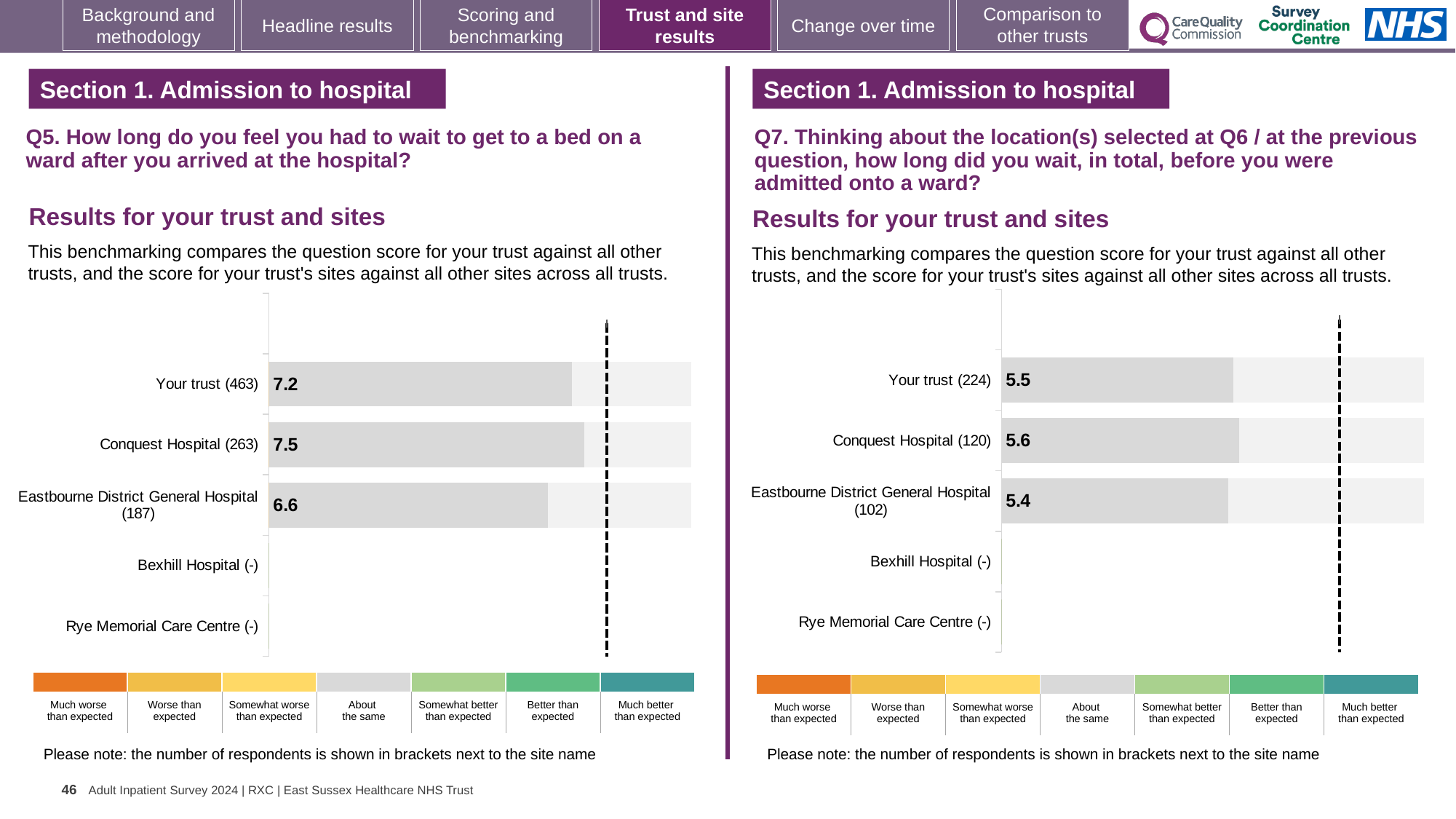
On the Q7 chart (right), which is larger, the score for Conquest Hospital or the score for Eastbourne District General Hospital? Conquest Hospital On the Q5 chart (left), how many respondents are shown for Your trust? 463 On the Q5 chart (left), what is the score for Conquest Hospital? 7.5 On the Q5 chart (left), what is the difference between the scores for Conquest Hospital and Eastbourne District General Hospital? 0.9 On the Q5 chart (left), what is the score for Your trust? 7.2 On the Q7 chart (right), how many rows (trust and sites) are listed on the vertical axis? 5 On the Q7 chart (right), what is the score for Eastbourne District General Hospital? 5.4 On the Q5 chart (left), which site or trust row has the highest score? Conquest Hospital On the Q7 chart (right), what is the difference between the scores for Conquest Hospital and Your trust? 0.1 On the Q7 chart (right), what is the score for Your trust? 5.5 What kind of chart is used on the Q5 chart (left)? Bar chart On the Q5 chart (left), what is the score for Eastbourne District General Hospital? 6.6